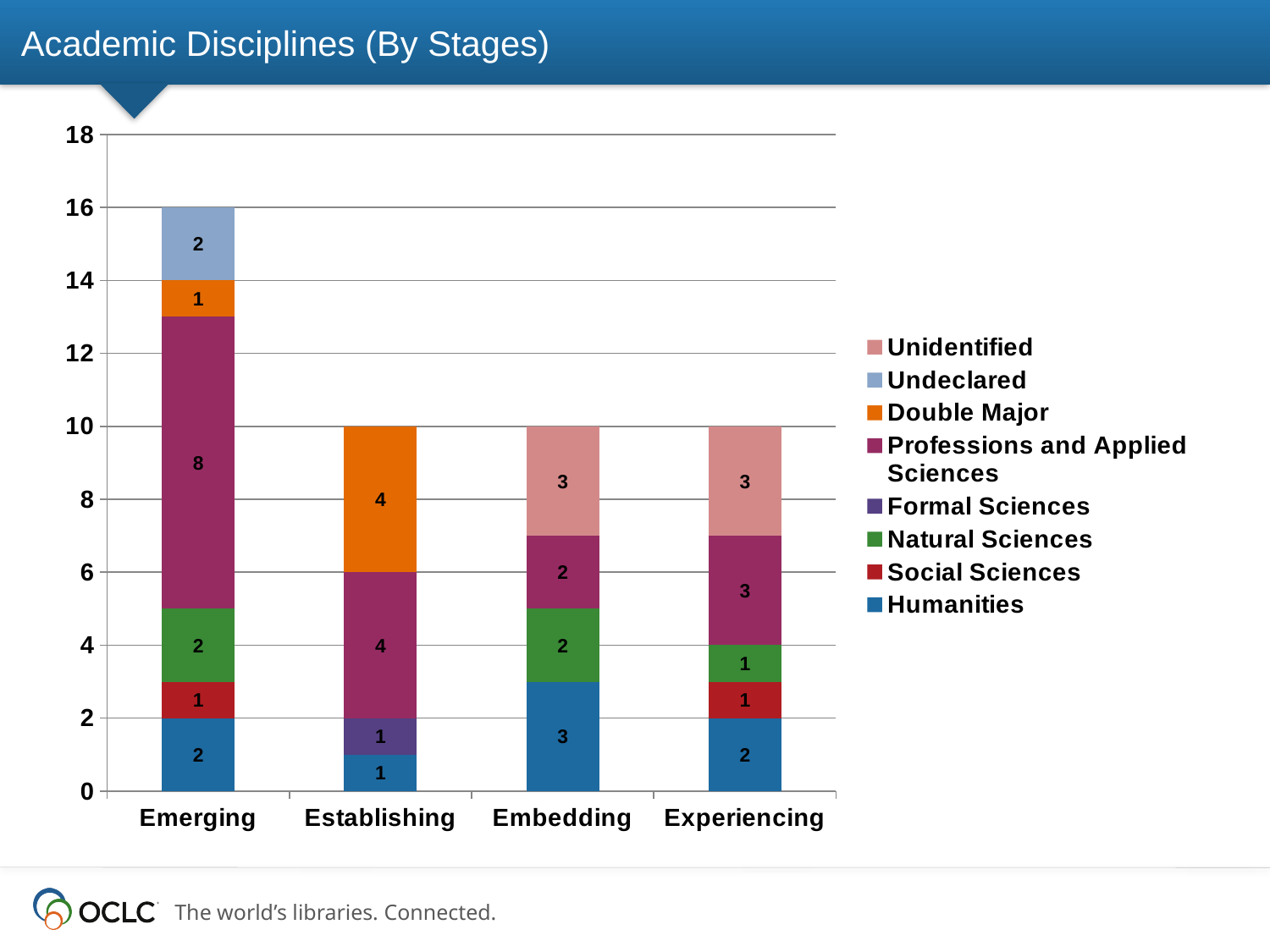
What is the total of the stacked bar for the Embedding stage? 10 What is the Humanities value for the Embedding stage? 3 What is the Unidentified value for the Experiencing stage? 3 What is the difference between the Professions and Applied Sciences values for Emerging and Establishing? 4 What is the total of the stacked bar for the Emerging stage? 16 Which is larger: the Humanities value for Embedding or the Humanities value for Establishing? Embedding What is the Professions and Applied Sciences value for the Emerging stage? 8 Which stage has the tallest stacked bar overall? Emerging What is the Double Major value for the Establishing stage? 4 How many stages are shown on the x axis? 4 What kind of chart is shown on the slide? Stacked bar chart How many series does the legend list? 8